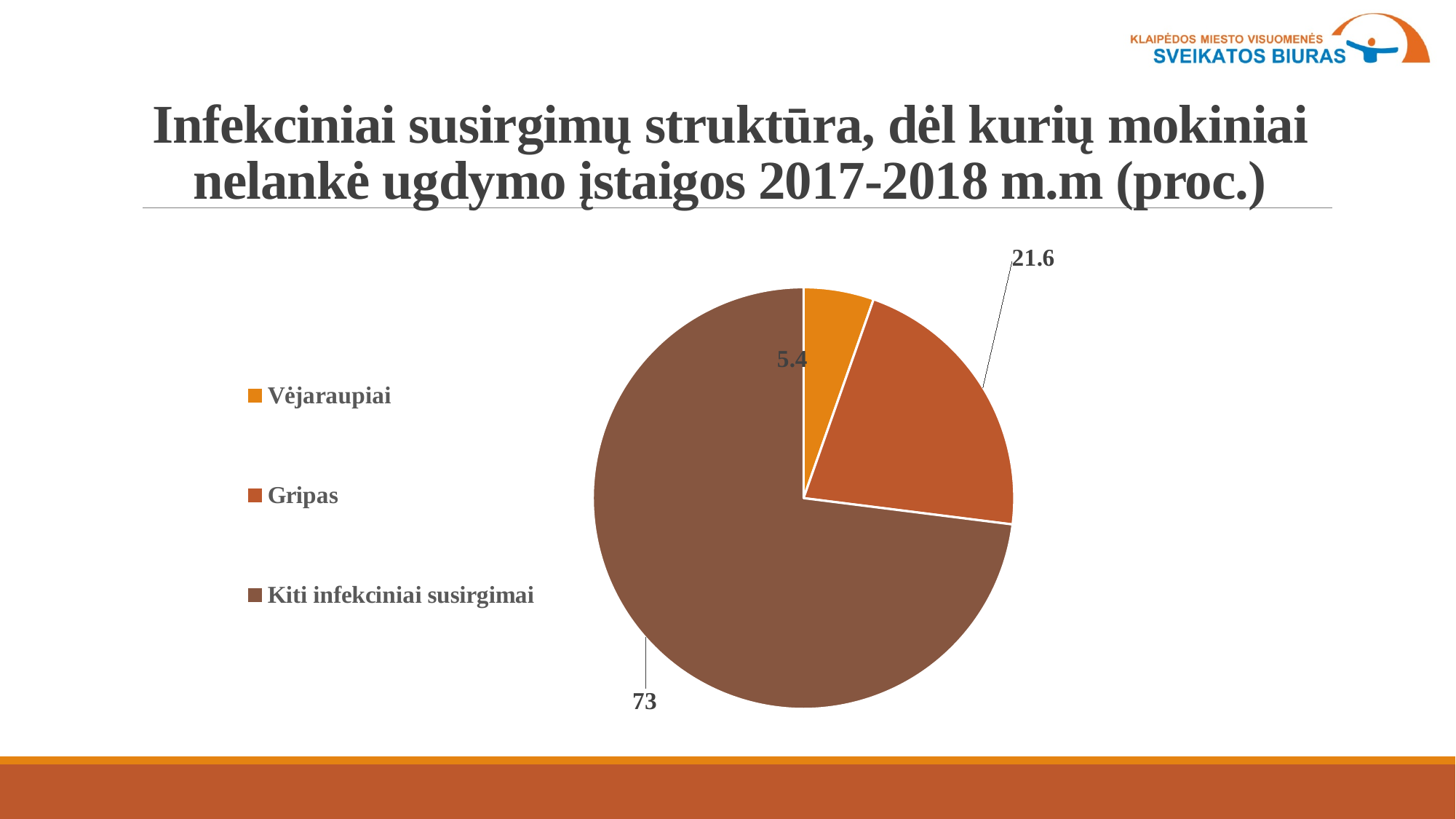
What is the difference between the values for Gripas and Vėjaraupiai? 16.2 Which is larger, the value for Gripas or the value for Vėjaraupiai? Gripas What is the value for Vėjaraupiai? 5.4 How many entries does the legend list? 3 What colour is the slice for Vėjaraupiai? orange How many categories does the pie chart show? 3 Which category has the smallest slice of the pie? Vėjaraupiai What is the value for Kiti infekciniai susirgimai? 73 Which category has the largest slice of the pie? Kiti infekciniai susirgimai What kind of chart is shown on the slide? pie chart What is the difference between the values for Kiti infekciniai susirgimai and Gripas? 51.4 What is the value for Gripas? 21.6